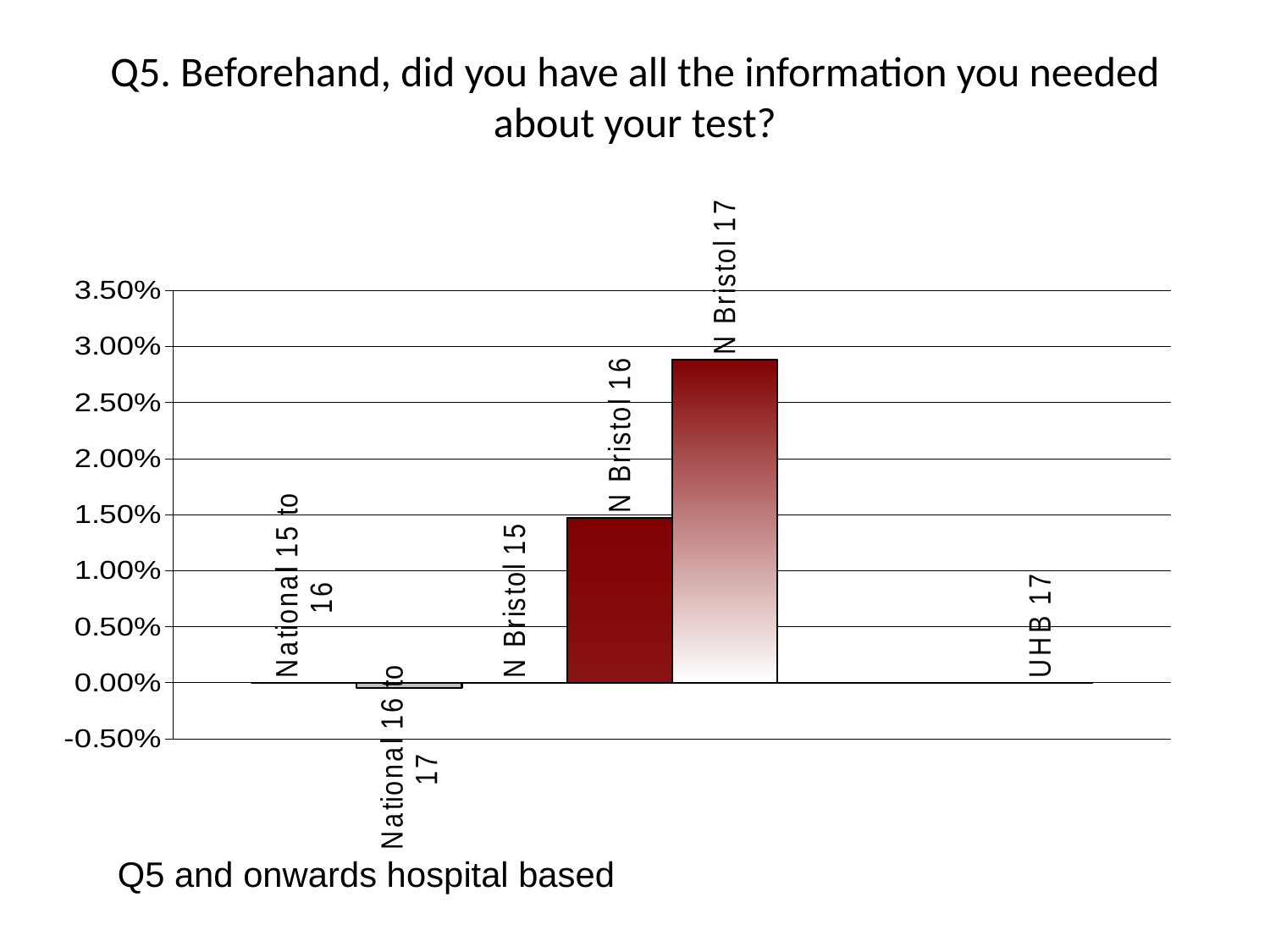
Is the value for N Bristol 17 greater or less than 2.50%? greater Which is larger, the value for N Bristol 16 or the value for N Bristol 17? N Bristol 17 Is the value for N Bristol 17 greater or less than 3.00%? less What kind of chart is shown on the slide? bar chart What is the title of the chart on the slide? Q5. Beforehand, did you have all the information you needed about your test? Is the value for N Bristol 16 greater or less than 2.00%? less Which category has the highest value in the chart? N Bristol 17 How many categories are shown on the x axis of the chart? 6 What is the highest tick value shown on the vertical axis of the chart? 3.50% Which category has the lowest value in the chart? National 16 to 17